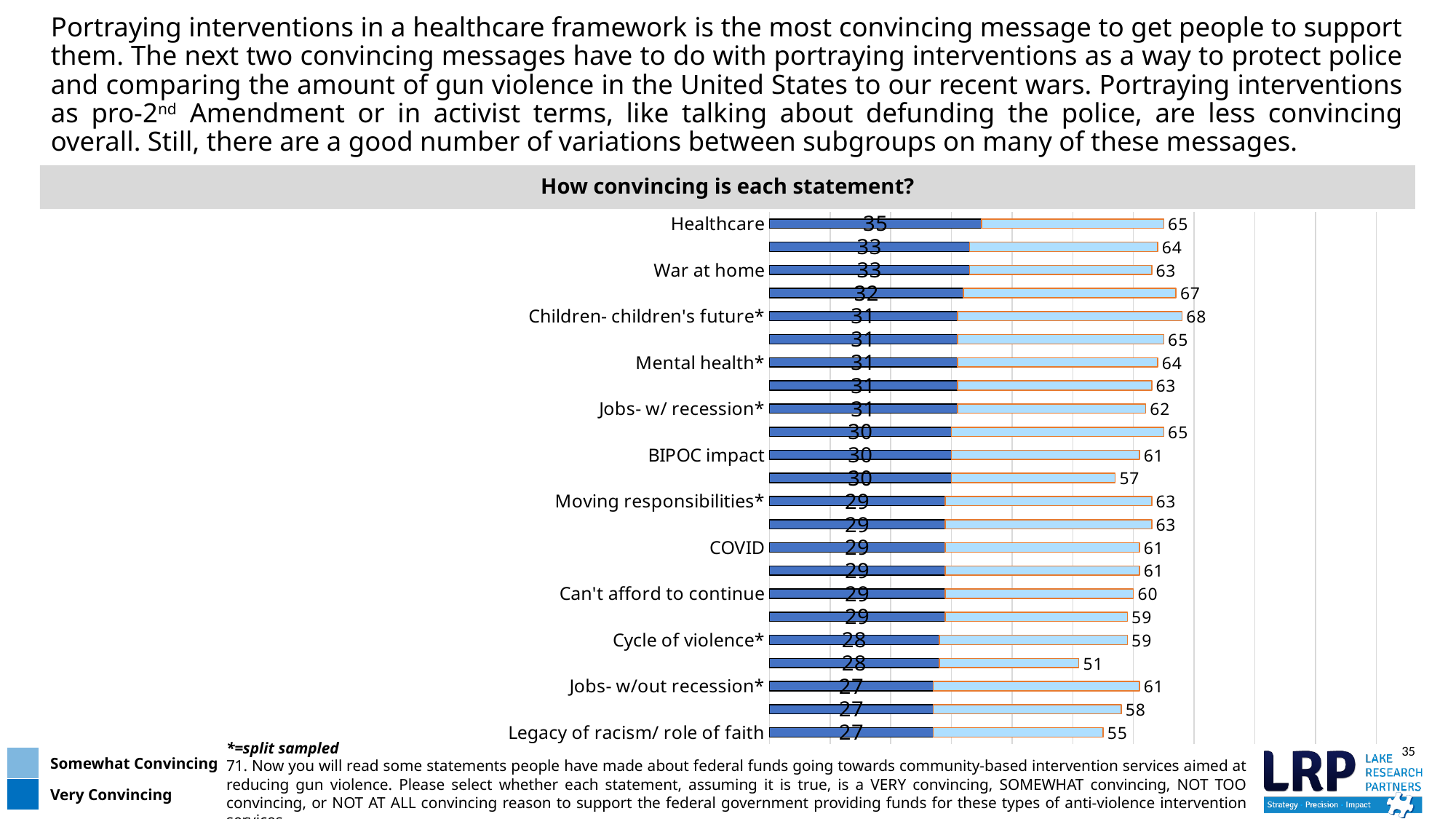
What is the difference between the Very Convincing values for Healthcare and Legacy of racism/ role of faith? 8 Which labeled statement has the highest Very Convincing value? Healthcare How many series does the legend list? 2 What number is printed at the end of the Children- children's future* bar? 68 What kind of chart is shown on the slide? Bar chart Which labeled statement has the highest number printed at the end of its bar? Children- children's future* What is the Very Convincing value for Cycle of violence*? 28 What is the title of the chart? How convincing is each statement? Which has a larger Very Convincing value, War at home or COVID? War at home What number is printed at the end of the Legacy of racism/ role of faith bar? 55 What is the Very Convincing value for War at home? 33 What is the Very Convincing value for Healthcare? 35